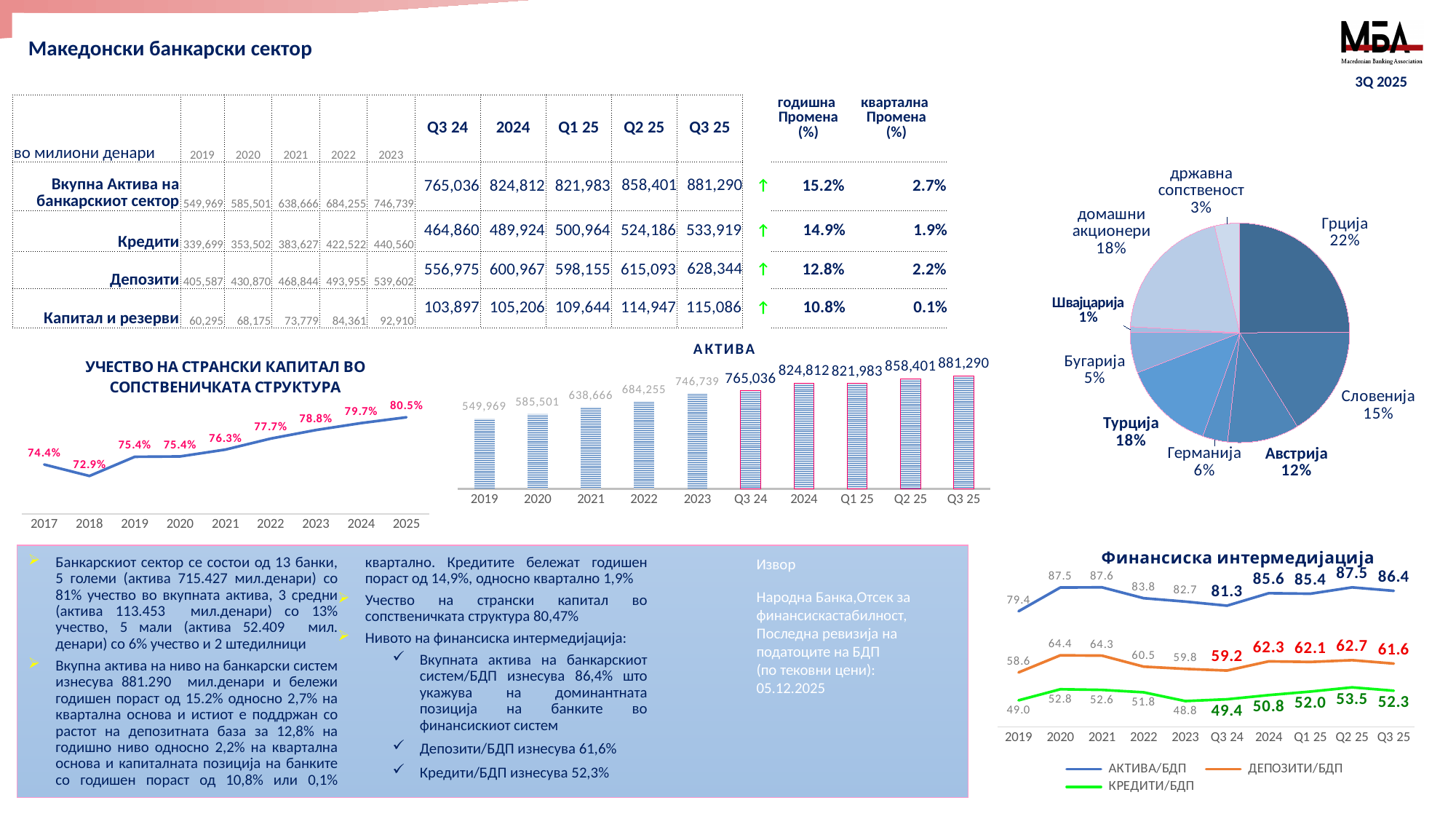
In the pie chart on the right, which slice is the smallest? Швајцарија In the chart 'УЧЕСТВО НА СТРАНСКИ КАПИТАЛ ВО СОПСТВЕНИЧКАТА СТРУКТУРА', what is the value for 2025? 80.5% How many categories are shown on the x axis of the 'АКТИВА' chart? 10 In the pie chart on the right, which is larger: Турција or Словенија? Турција How many series does the legend of the 'Финансиска интермедијација' chart list? 3 In the 'АКТИВА' chart, what is the value for Q3 25? 881,290 What kind of chart is the 'АКТИВА' chart? bar chart In the chart 'УЧЕСТВО НА СТРАНСКИ КАПИТАЛ ВО СОПСТВЕНИЧКАТА СТРУКТУРА', do the values rise or fall from 2018 to 2025? rise In the 'АКТИВА' chart, what is the difference between the values for 2024 and 2023? 78,073 In the pie chart on the right, what share does Грција have? 22% In the 'Финансиска интермедијација' chart, what is the value of АКТИВА/БДП for Q3 25? 86.4 In the chart 'УЧЕСТВО НА СТРАНСКИ КАПИТАЛ ВО СОПСТВЕНИЧКАТА СТРУКТУРА', which year has the lowest value? 2018